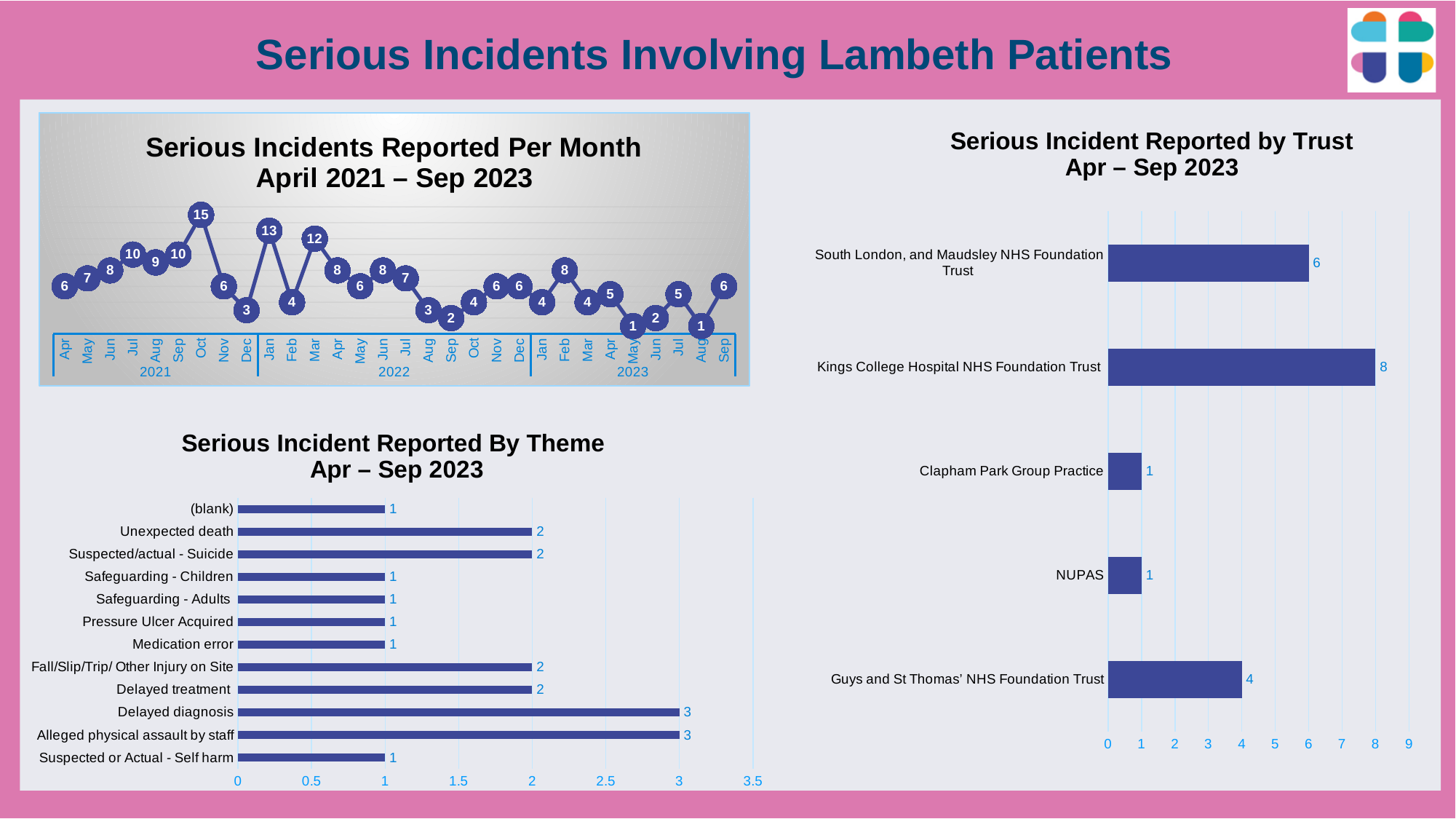
In the 'Serious Incidents Reported Per Month' chart, what is the difference between the values for January 2022 and February 2022? 9 In the 'Serious Incidents Reported Per Month' chart, which month has the highest number of incidents? Oct 2021 In the 'Serious Incident Reported by Trust' chart, how many incidents were reported for Kings College Hospital NHS Foundation Trust? 8 In the 'Serious Incident Reported by Trust' chart, how many trusts are listed? 5 In the 'Serious Incident Reported By Theme' chart, how many incidents were reported for Delayed diagnosis? 3 In the 'Serious Incident Reported by Trust' chart, which trust has the highest number of incidents? Kings College Hospital NHS Foundation Trust In the 'Serious Incidents Reported Per Month' chart, how many incidents were reported in March 2022? 12 In the 'Serious Incident Reported By Theme' chart, how many theme categories are shown? 12 In the 'Serious Incident Reported by Trust' chart, what is the difference between South London, and Maudsley NHS Foundation Trust and Guys and St Thomas' NHS Foundation Trust? 2 In the 'Serious Incidents Reported Per Month' chart, how many serious incidents were reported in October 2021? 15 In the 'Serious Incident Reported By Theme' chart, which is larger: Unexpected death or Medication error? Unexpected death What kind of chart is 'Serious Incidents Reported Per Month April 2021 – Sep 2023'? Line chart